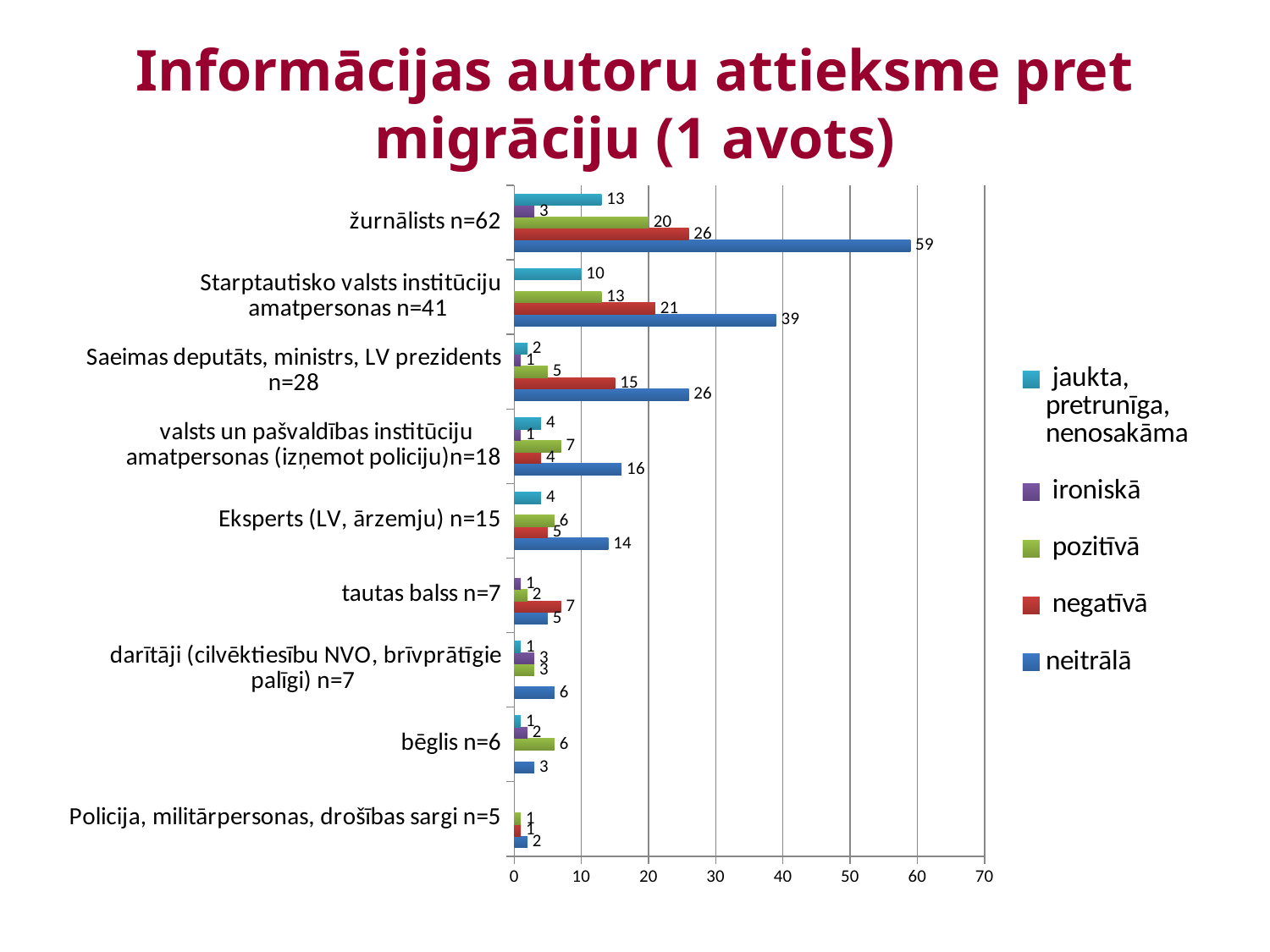
Which category has the lowest neitrālā value? Policija, militārpersonas, drošības sargi n=5 Is the neitrālā value for Saeimas deputāts, ministrs, LV prezidents n=28 greater or less than 20? greater What is the difference between the neitrālā values for žurnālists n=62 and Starptautisko valsts institūciju amatpersonas n=41? 20 What is the negatīvā value for Starptautisko valsts institūciju amatpersonas n=41? 21 What is the pozitīvā value for bēglis n=6? 6 What is the neitrālā value for žurnālists n=62? 59 Which category has the highest neitrālā value? žurnālists n=62 How many categories are shown on the vertical axis of the chart? 9 What is the title of the chart on the slide? Informācijas autoru attieksme pret migrāciju (1 avots) What type of chart is shown on the slide? bar chart For tautas balss n=7, which is larger: the negatīvā value or the neitrālā value? negatīvā How many series does the legend list? 5